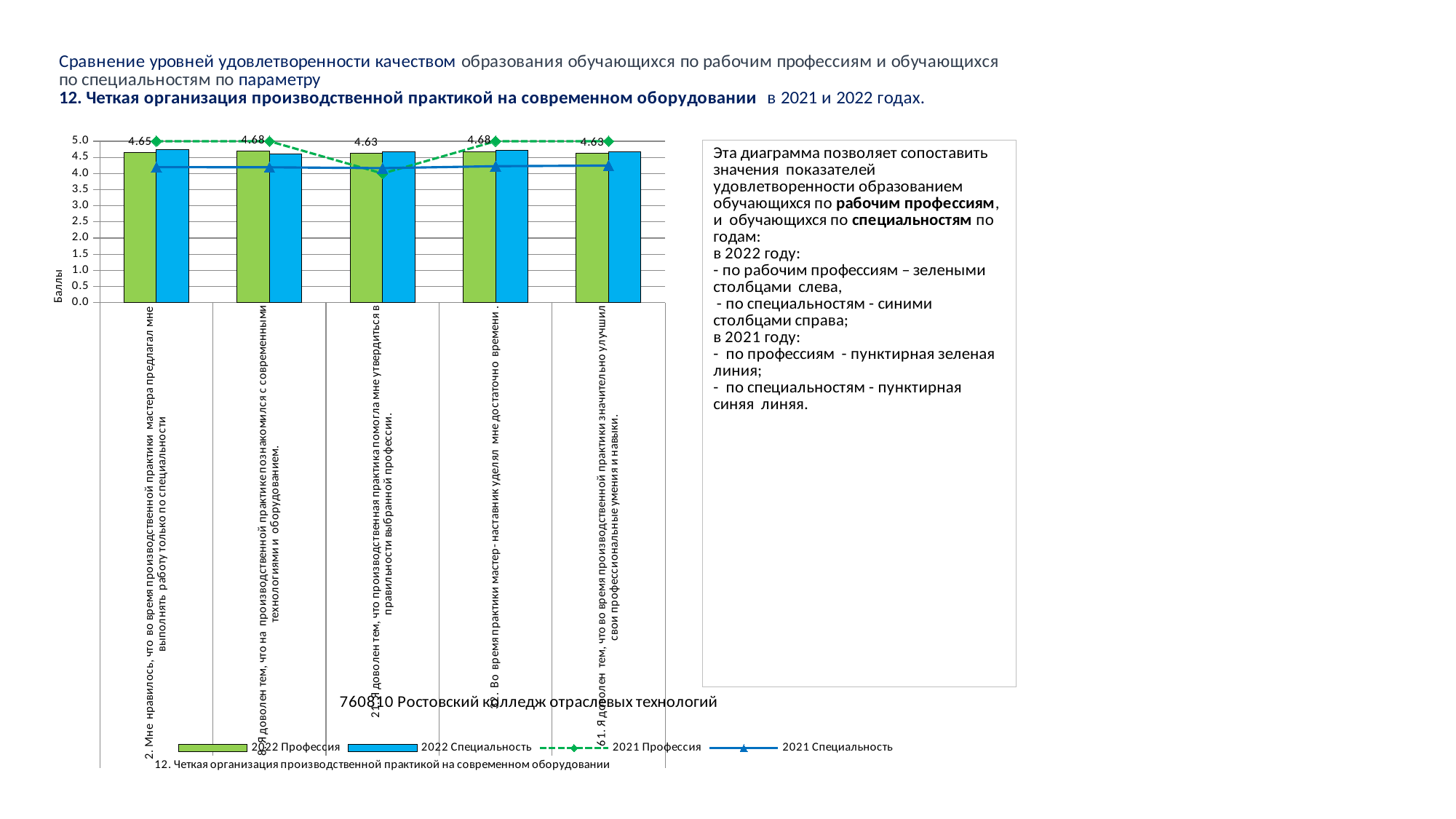
What is the value of the 2022 Профессия series for category 21 (Я доволен тем, что производственная практика помогла мне утвердиться в правильности выбранной профессии)? 4.63 What is the value of the 2022 Профессия series for category 2 (Мне нравилось, что во время производственной практики мастера предлагал мне выполнять работу только по специальности)? 4.65 For the 2022 Профессия series, which is larger: the value for category 8 or the value for category 21? category 8 How many series does the legend list? 4 What is the value of the 2022 Профессия series for category 61 (Я доволен тем, что во время производственной практики значительно улучшил свои профессиональные умения и навыки)? 4.63 Is the value of the 2021 Профессия series for category 2 greater or less than 4.5? greater For the 2022 Профессия series, what is the difference between the value for category 8 (4.68) and the value for category 21 (4.63)? 0.05 What is the value of the 2022 Профессия series for category 8 (Я доволен тем, что на производственной практике познакомился с современными технологиями и оборудованием)? 4.68 What kind of chart is shown on the slide? a combined bar and line chart Is the value of the 2021 Специальность series for category 2 greater or less than 4.5? less What is the title of the vertical axis? Баллы How many categories are shown on the x axis? 5